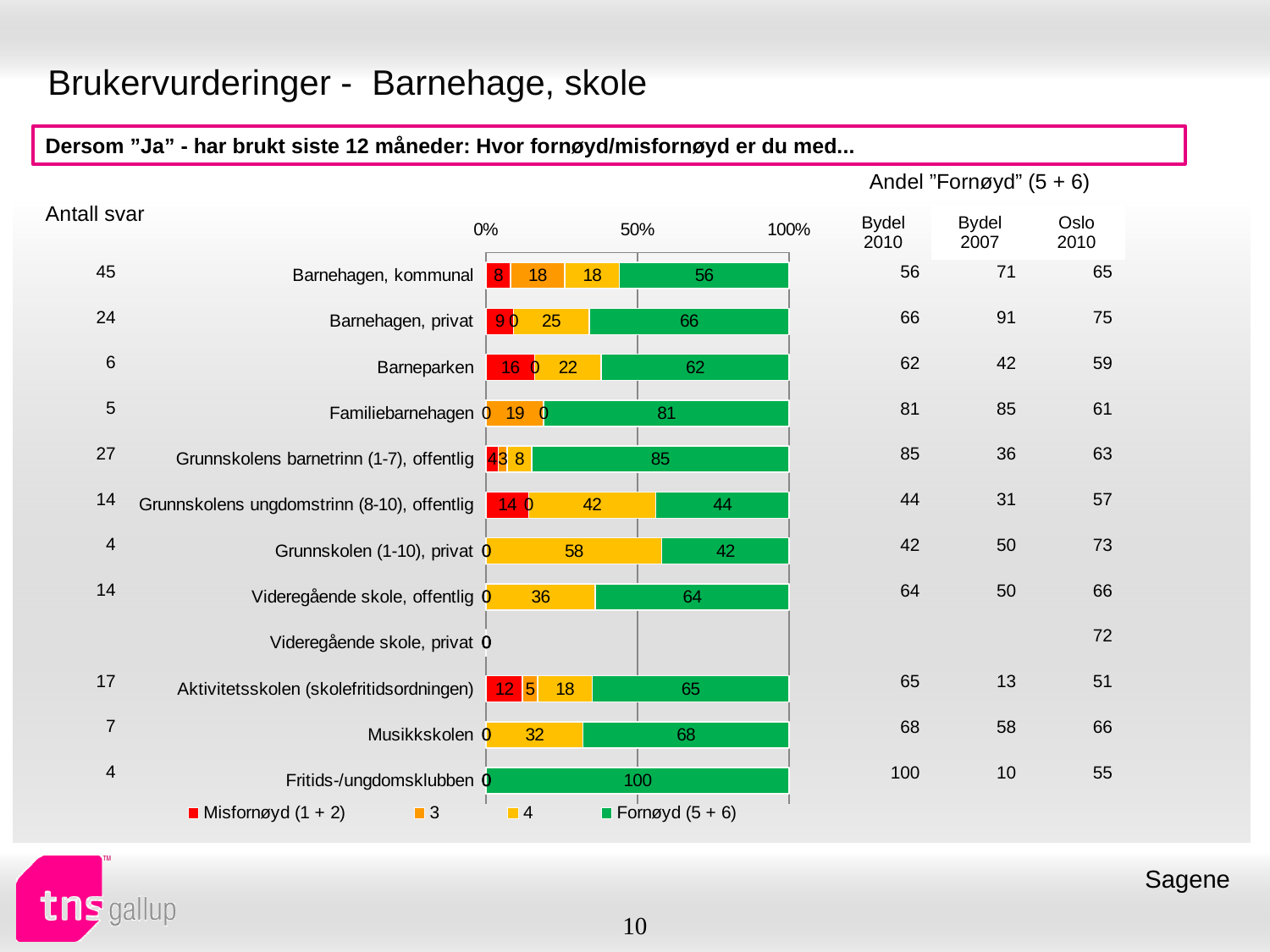
What is the value of series 4 for Grunnskolens ungdomstrinn (8-10), offentlig? 42 How many categories are listed on the chart's vertical axis? 12 What kind of chart is shown on the slide? Stacked bar chart Which has a larger Fornøyd (5 + 6) value: Grunnskolens barnetrinn (1-7), offentlig or Videregående skole, offentlig? Grunnskolens barnetrinn (1-7), offentlig How many series does the legend list? 4 What is the difference between the Fornøyd (5 + 6) values for Familiebarnehagen and Barnehagen, kommunal? 25 Among the categories with plotted bars, which has the lowest Fornøyd (5 + 6) value? Grunnskolen (1-10), privat Which category has the highest Fornøyd (5 + 6) value? Fritids-/ungdomsklubben What is the Misfornøyd (1 + 2) value for Aktivitetsskolen (skolefritidsordningen)? 12 What is the Fornøyd (5 + 6) value for Barnehagen, kommunal? 56 What is the Misfornøyd (1 + 2) value for Barneparken? 16 What colour represents Fornøyd (5 + 6) in the legend? Green